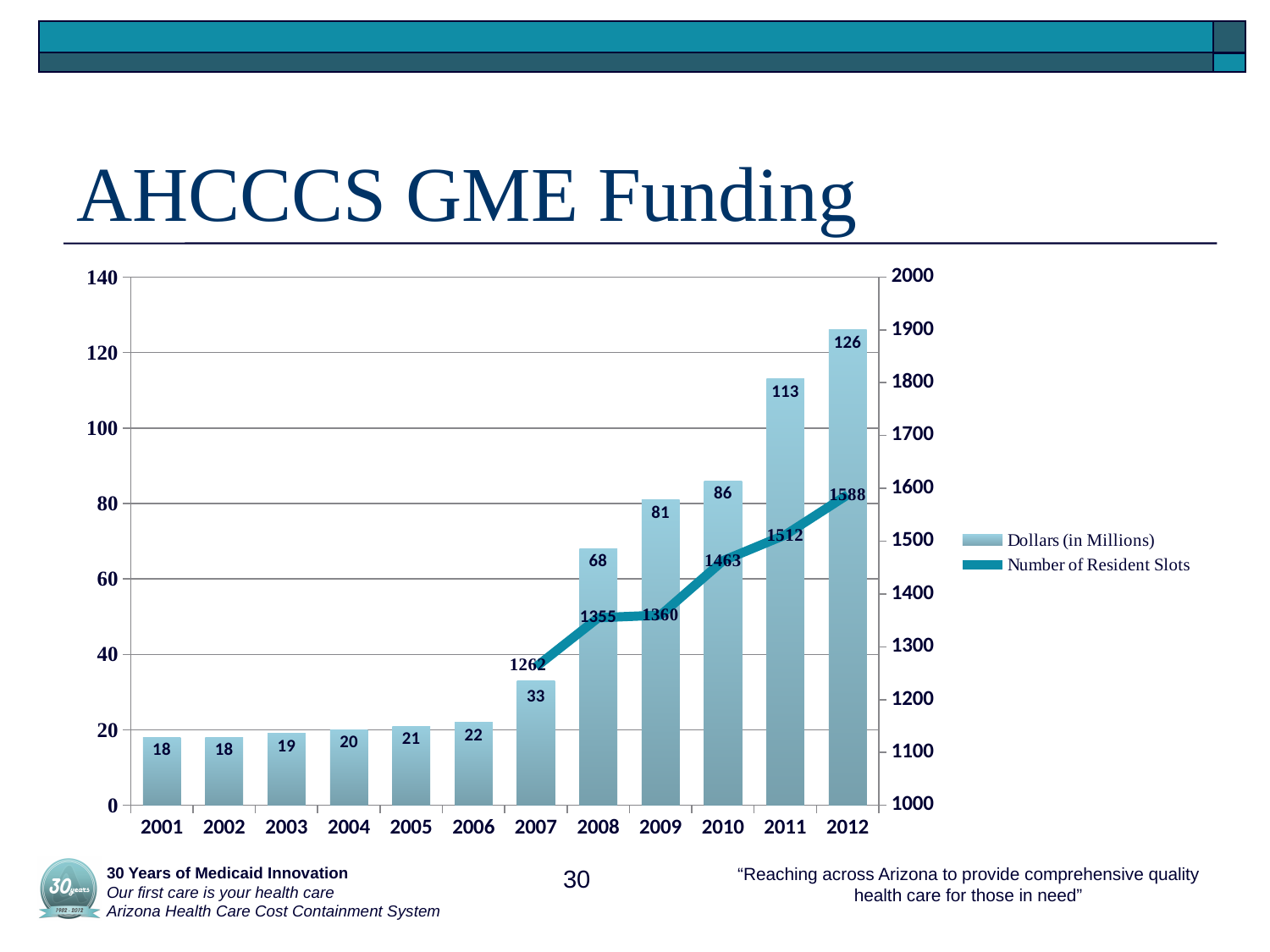
What is the difference in Dollars (in Millions) between 2011 and 2010? 27 Which year has the highest Dollars (in Millions) value? 2012 What is the Dollars (in Millions) value for 2012? 126 What is the difference in Number of Resident Slots between 2012 and 2011? 76 Do the Dollars (in Millions) values rise or fall from 2001 to 2012? Rise How many series does the legend list? 2 Which year has the lowest Number of Resident Slots? 2007 What is the Number of Resident Slots for 2010? 1463 Which is larger, the Dollars (in Millions) value for 2008 or for 2009? 2009 What is the Dollars (in Millions) value for 2007? 33 What kind of chart is used for the Dollars (in Millions) series? Bar chart How many years are shown on the x axis? 12